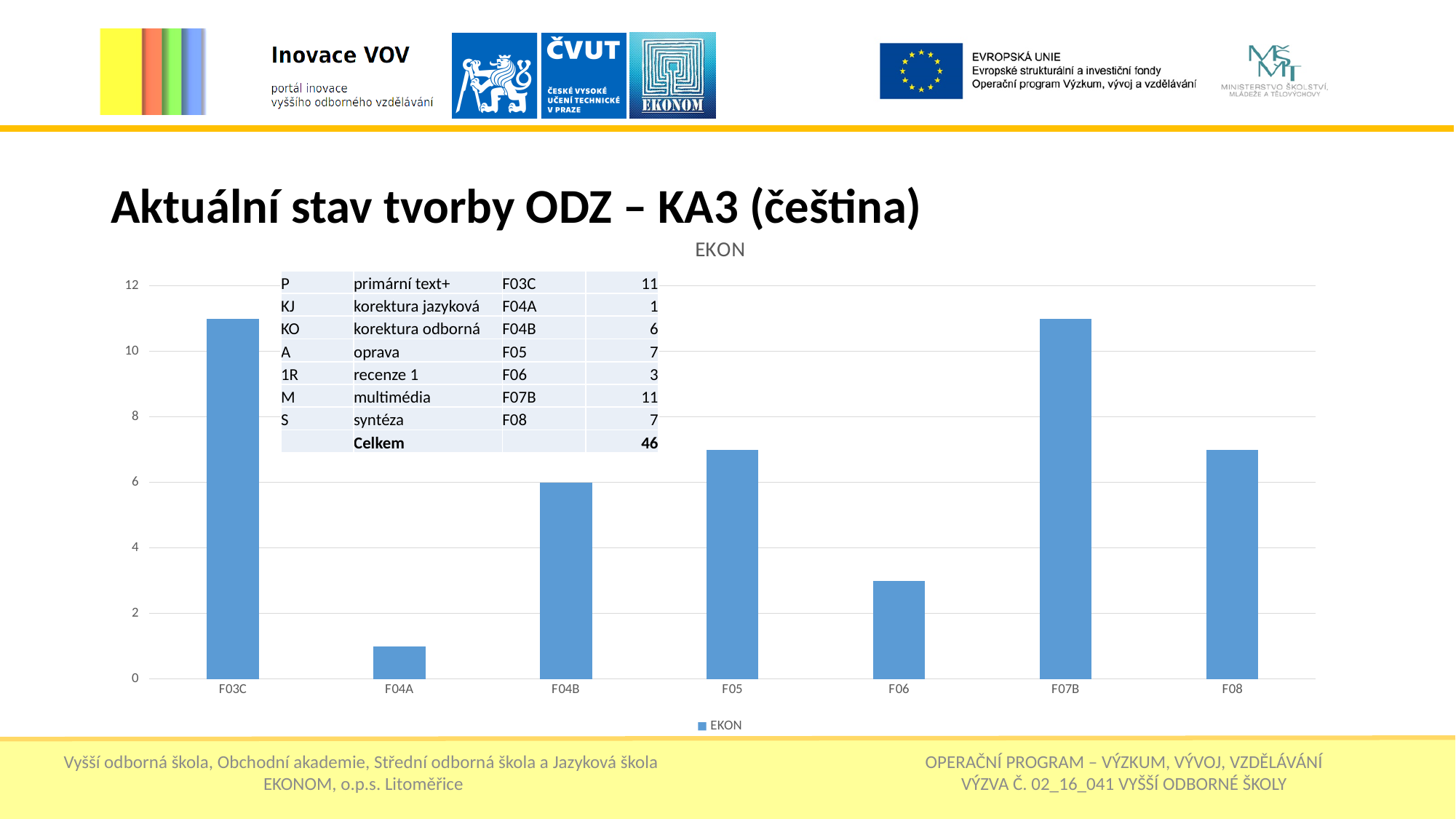
What is the difference between the values for F05 and F06? 4 What is the difference between the values for F03C and F04A? 10 What is the total (Celkem) of all values shown in the table on the chart? 46 Which is larger, the value for F04B or the value for F08? F08 What is the value for F07B in the EKON chart? 11 What type of chart is shown on the slide? bar chart Is the value for F07B greater or less than 10? greater Which category has the lowest value in the EKON chart? F04A What is the value for F04B in the EKON chart? 6 How many categories are shown on the x axis of the chart? 7 What is the value for F06 in the EKON chart? 3 How many series does the chart legend list? 1